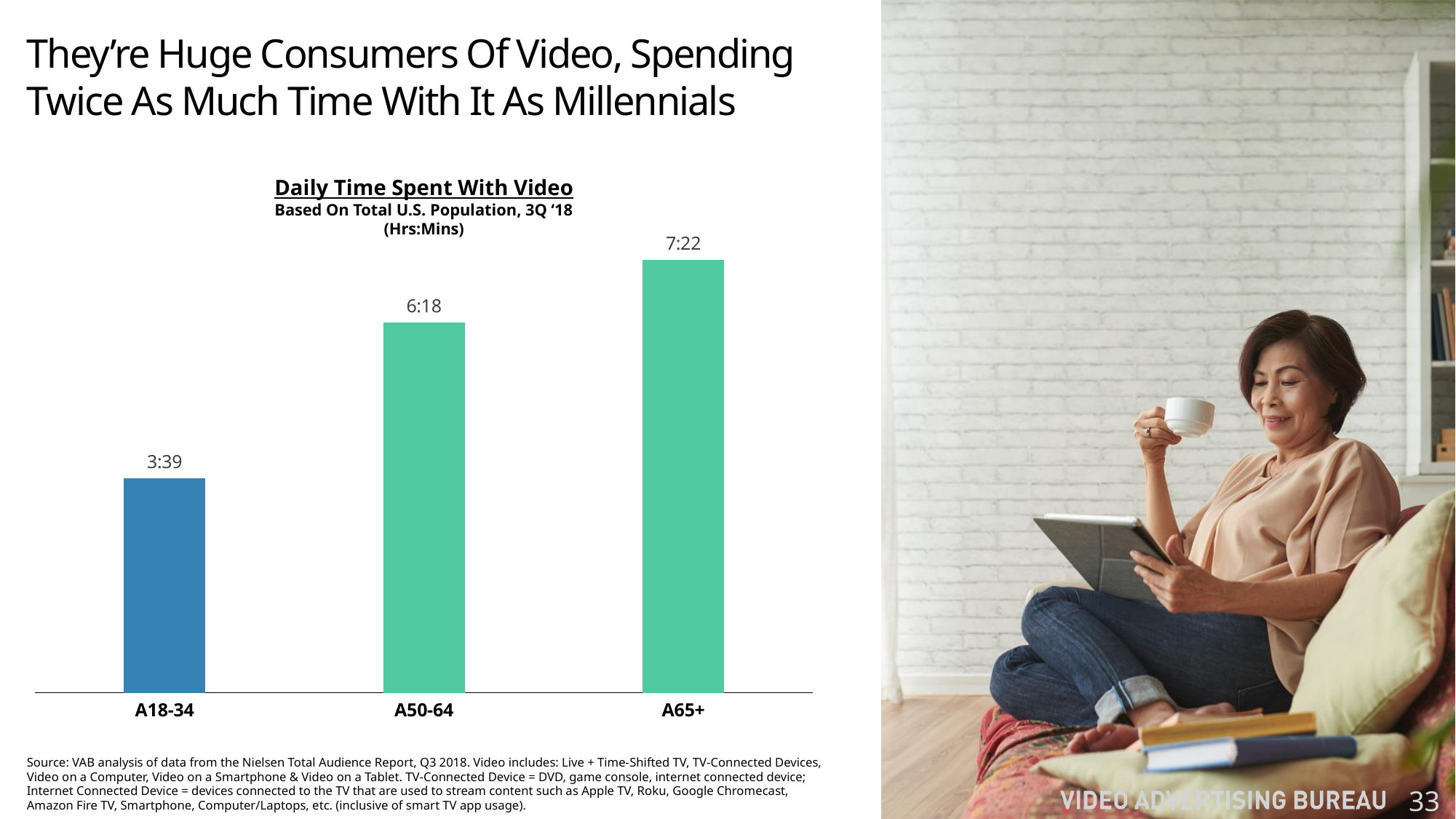
How much more daily time does A65+ spend with video than A18-34? 3:43 How much more daily time does A50-64 spend with video than A18-34? 2:39 Which spends more daily time with video, A50-64 or A65+? A65+ What is the daily time spent with video for A18-34? 3:39 What is the daily time spent with video for A50-64? 6:18 How many age groups are shown in the chart? 3 Which age group has the highest daily time spent with video? A65+ Which age group has the lowest daily time spent with video? A18-34 Do the values rise or fall from A18-34 to A65+ along the x axis? Rise What is the daily time spent with video for A65+? 7:22 What kind of chart is used to show daily time spent with video? Bar chart Which bar is coloured blue rather than green? A18-34